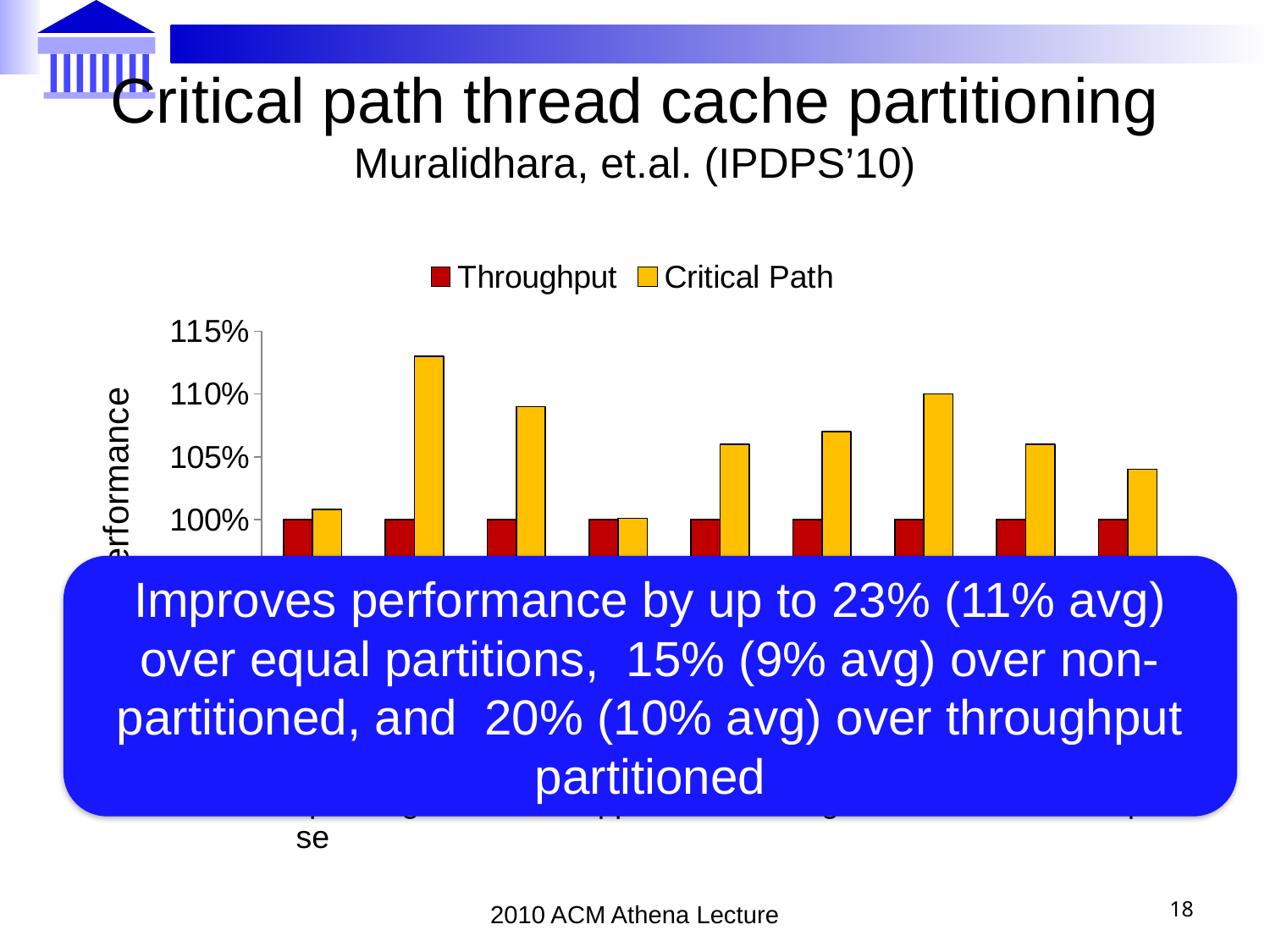
Is the Critical Path value for the seventh group of bars from the left greater or less than 105%? greater What are the two series named in the chart's legend? Throughput and Critical Path Is the Critical Path value for the third group of bars from the left greater or less than 105%? greater In the second group of bars from the left, which series has the larger value, Throughput or Critical Path? Critical Path What is the highest value shown on the chart's y axis? 115% Is the Critical Path value for the second group of bars from the left greater or less than 110%? greater Which colour represents the Critical Path series in the chart? yellow Which group of bars has the highest Critical Path value? the second group from the left How many series does the chart's legend list? 2 How many groups of bars are plotted in the chart? 9 What kind of chart is shown on the slide? bar chart